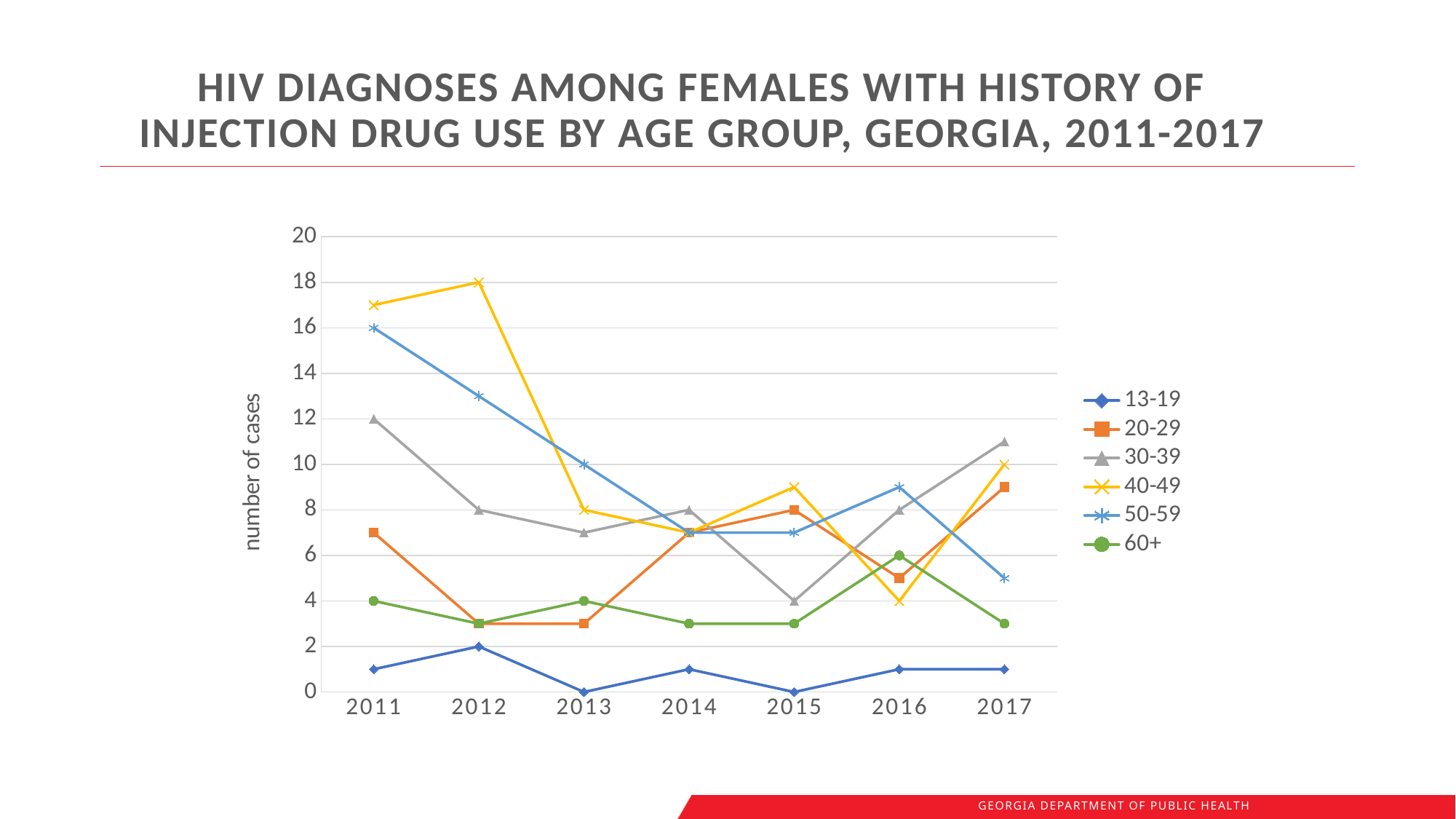
Does the number of cases for the 50-59 age group rise or fall from 2011 to 2014? fall What type of chart is shown on the slide? line chart How many age-group series does the legend list? 6 What is the number of cases for the 50-59 age group in 2011? 16 Which age group had the lowest number of cases in 2011? 13-19 What is the number of cases for the 13-19 age group in 2013? 0 Is the value for the 40-49 age group in 2011 greater or less than 14? greater Which is larger in 2012, the value for 40-49 or the value for 30-39? 40-49 What is the number of cases for the 30-39 age group in 2011? 12 How many years are plotted along the x axis? 7 Which age group had the highest number of cases in 2012? 40-49 What is the number of cases for the 40-49 age group in 2012? 18